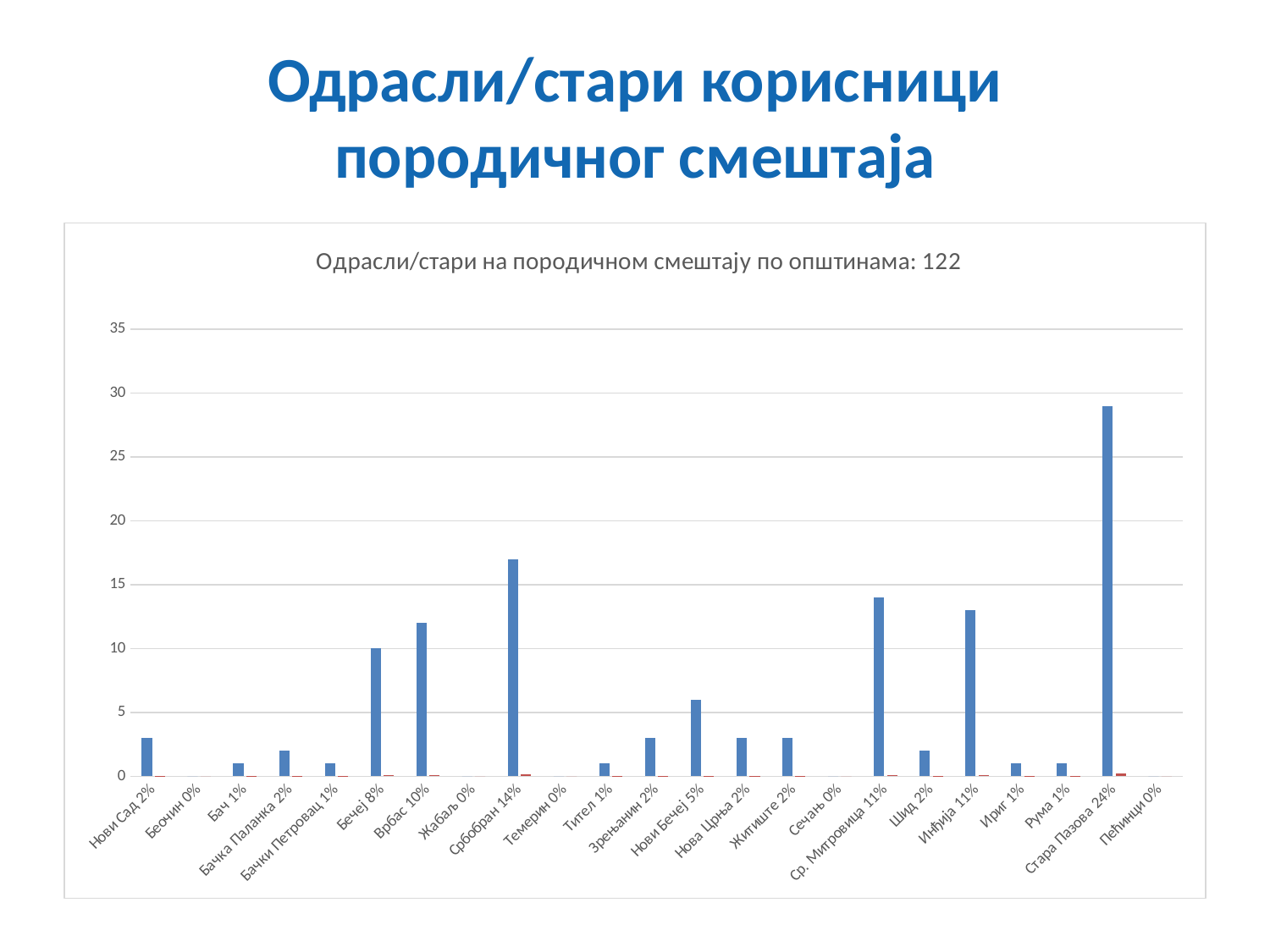
What kind of chart is shown on the slide? bar chart Is the value for Нови Бечеј 5% greater or less than 5? greater What is the title of the chart? Одрасли/стари на породичном смештају по општинама: 122 What percentage is shown in the axis label for Инђија? 11% Is the value for Стара Пазова 24% greater or less than 25? greater Is the value for Врбас 10% greater or less than 10? greater Which category has the highest bar? Стара Пазова 24% Which is larger, the value for Ср. Митровица 11% or the value for Шид 2%? Ср. Митровица 11% What is the value for Бечеј 8%? 10 How many categories are shown on the x axis? 23 Which is larger, the value for Србобран 14% or the value for Врбас 10%? Србобран 14%